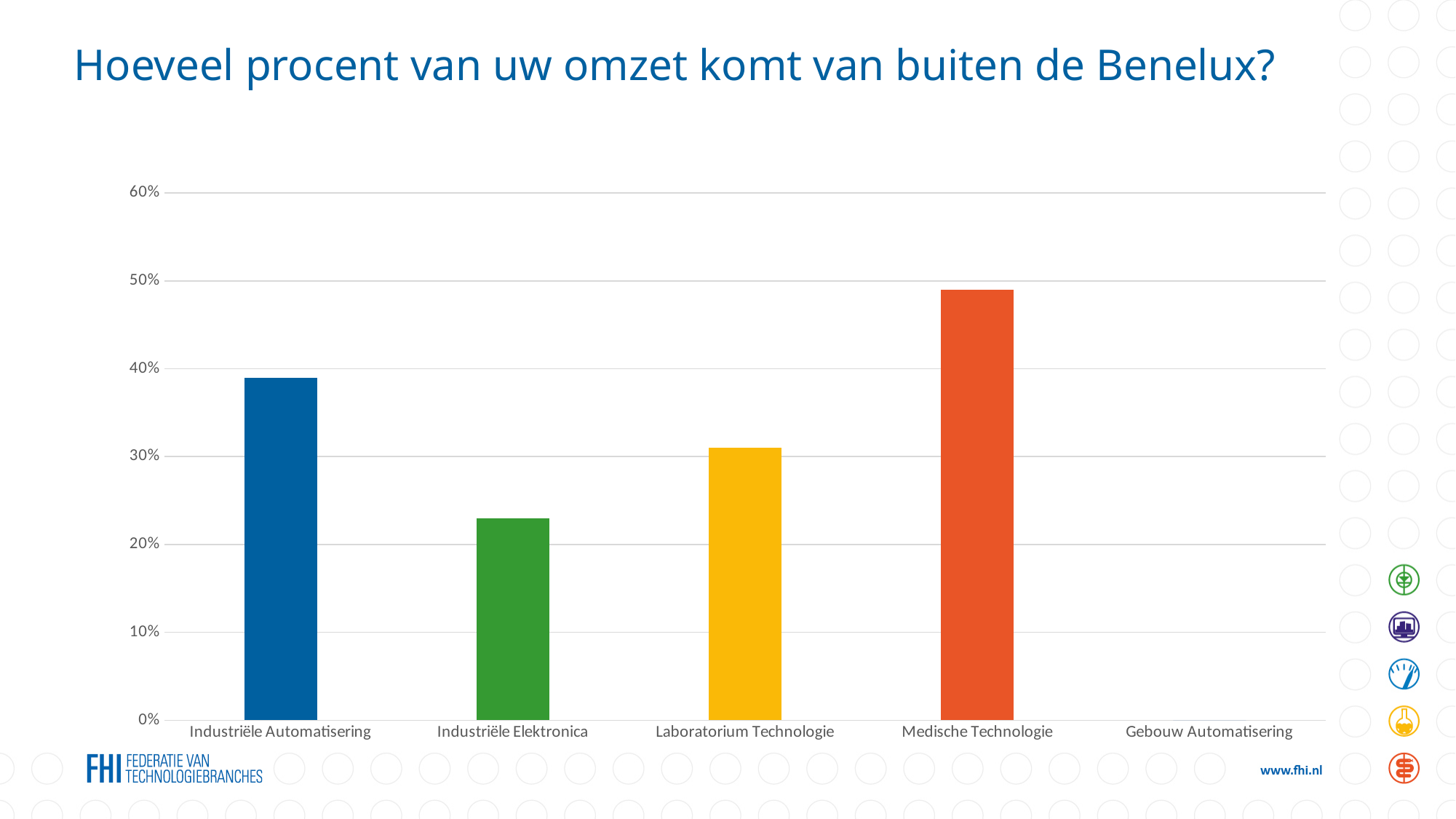
Is the value for Laboratorium Technologie greater or less than 30%? greater Is the value for Medische Technologie greater or less than 40%? greater Which is larger, the value for Industriële Automatisering or the value for Laboratorium Technologie? Industriële Automatisering Is the value for Medische Technologie greater or less than 50%? less What type of chart is shown on the slide? bar chart Which category has the highest value? Medische Technologie Which is larger, the value for Industriële Elektronica or the value for Medische Technologie? Medische Technologie How many categories are shown on the x axis? 5 What colour is the bar for Medische Technologie? red-orange What is the title of the chart? Hoeveel procent van uw omzet komt van buiten de Benelux?